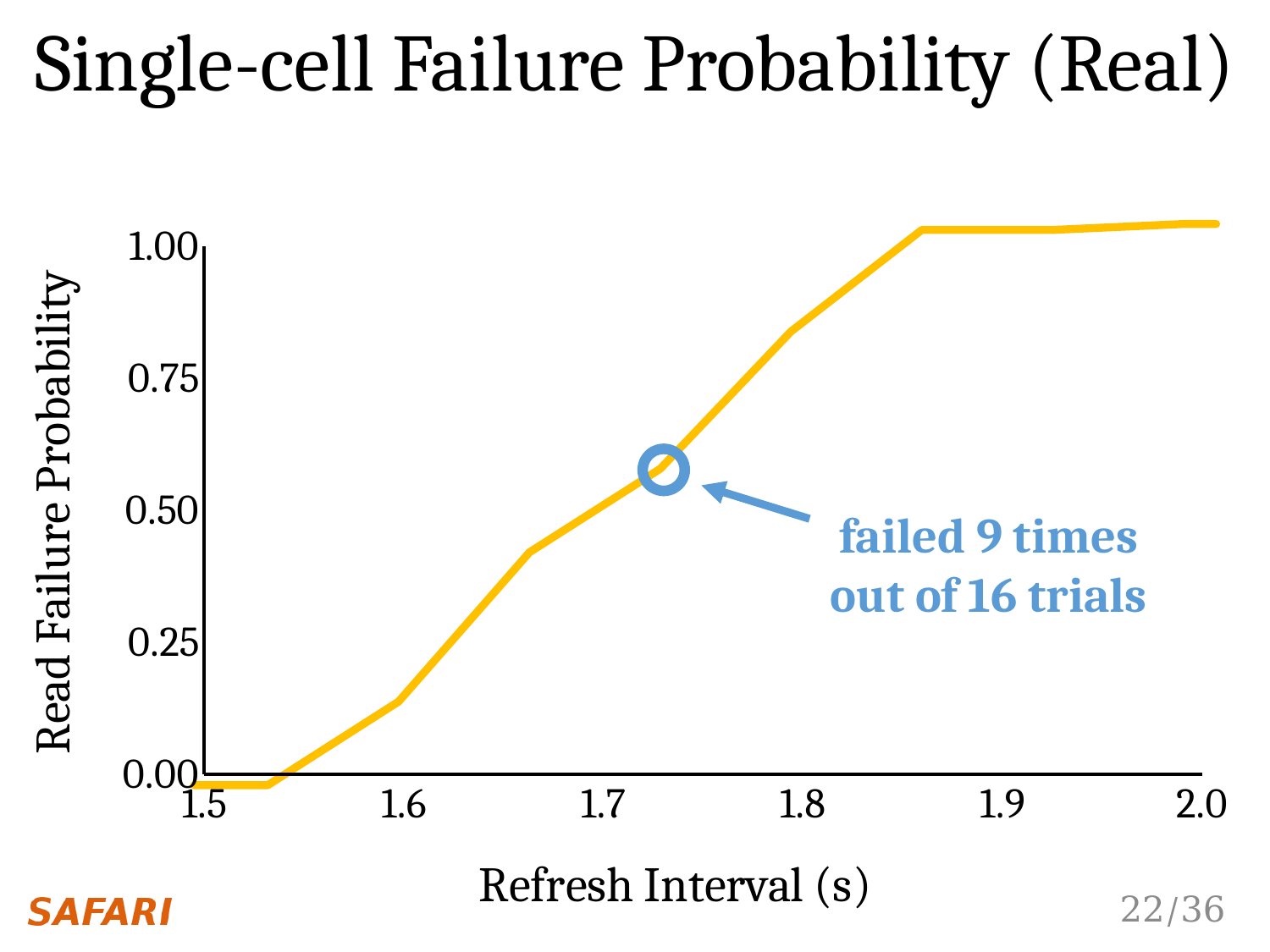
Is the read failure probability at a refresh interval of 1.8 s greater or less than 0.50? greater What kind of chart is shown on the slide? Line chart According to the annotation, how many times out of 16 trials did the circled point fail? 9 times Is the read failure probability at a refresh interval of 1.6 s greater or less than 0.25? less Which refresh interval has the higher read failure probability, 1.6 s or 1.8 s? 1.8 s What is the label of the x axis? Refresh Interval (s) How many lines (series) are plotted on the chart? 1 Is the read failure probability at a refresh interval of 1.5 s greater or less than 0.25? less Does the read failure probability rise or fall as the refresh interval increases from 1.5 s to 2.0 s? Rises